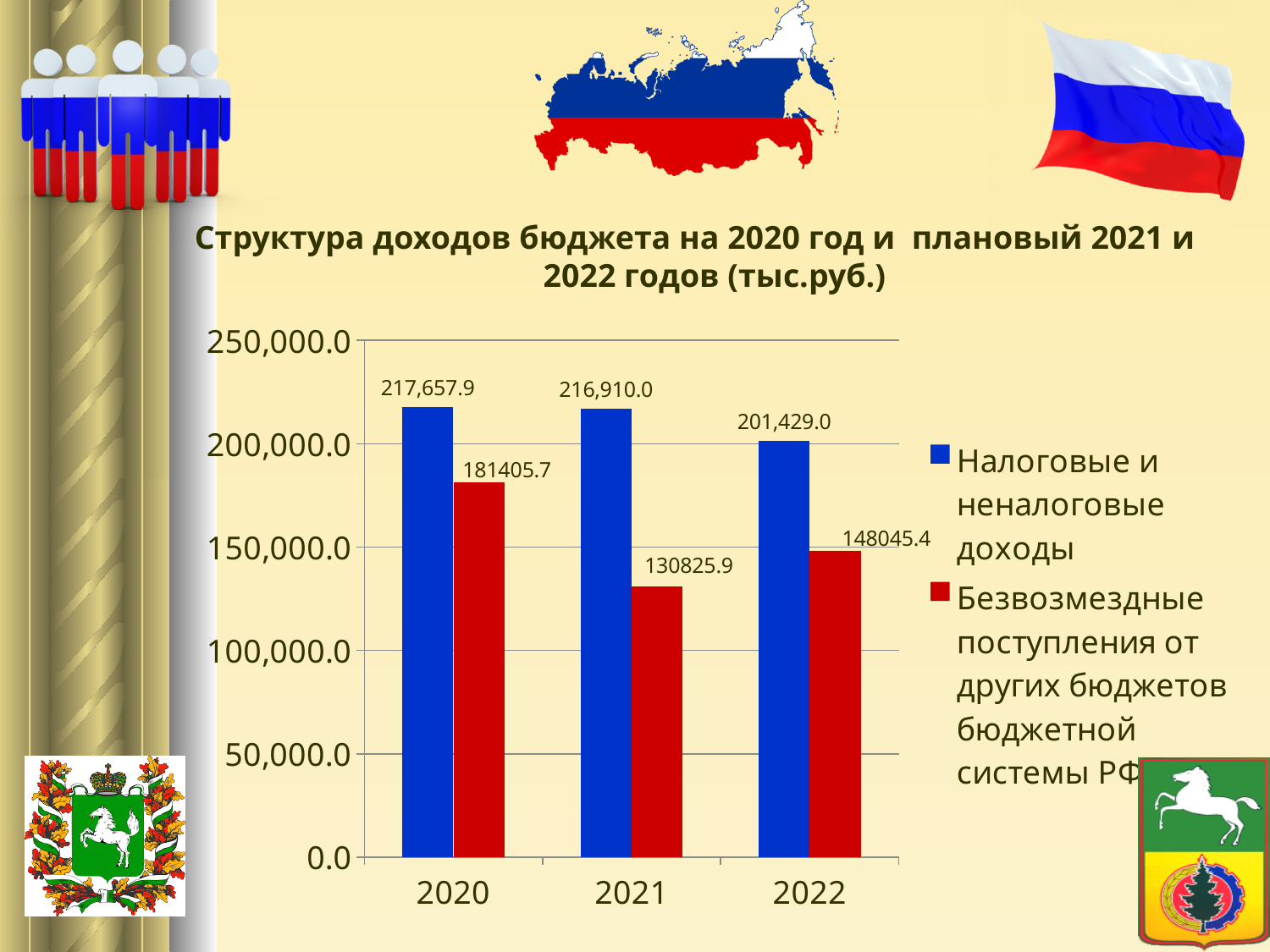
What is the value of Безвозмездные поступления от других бюджетов бюджетной системы РФ for 2021? 130825.9 What is the value of Налоговые и неналоговые доходы for 2022? 201,429.0 What is the value of Налоговые и неналоговые доходы for 2020? 217,657.9 What is the value of Безвозмездные поступления от других бюджетов бюджетной системы РФ for 2022? 148045.4 In which year is Налоговые и неналоговые доходы highest? 2020 How many years are shown on the x axis? 3 Which is larger in 2022: Налоговые и неналоговые доходы or Безвозмездные поступления от других бюджетов? Налоговые и неналоговые доходы How many series does the legend list? 2 What is the difference between Налоговые и неналоговые доходы and Безвозмездные поступления in 2021? 86084.1 What kind of chart is shown on the slide? bar chart In which year is Безвозмездные поступления от других бюджетов бюджетной системы РФ lowest? 2021 What is the difference between Безвозмездные поступления in 2020 and in 2021? 50579.8